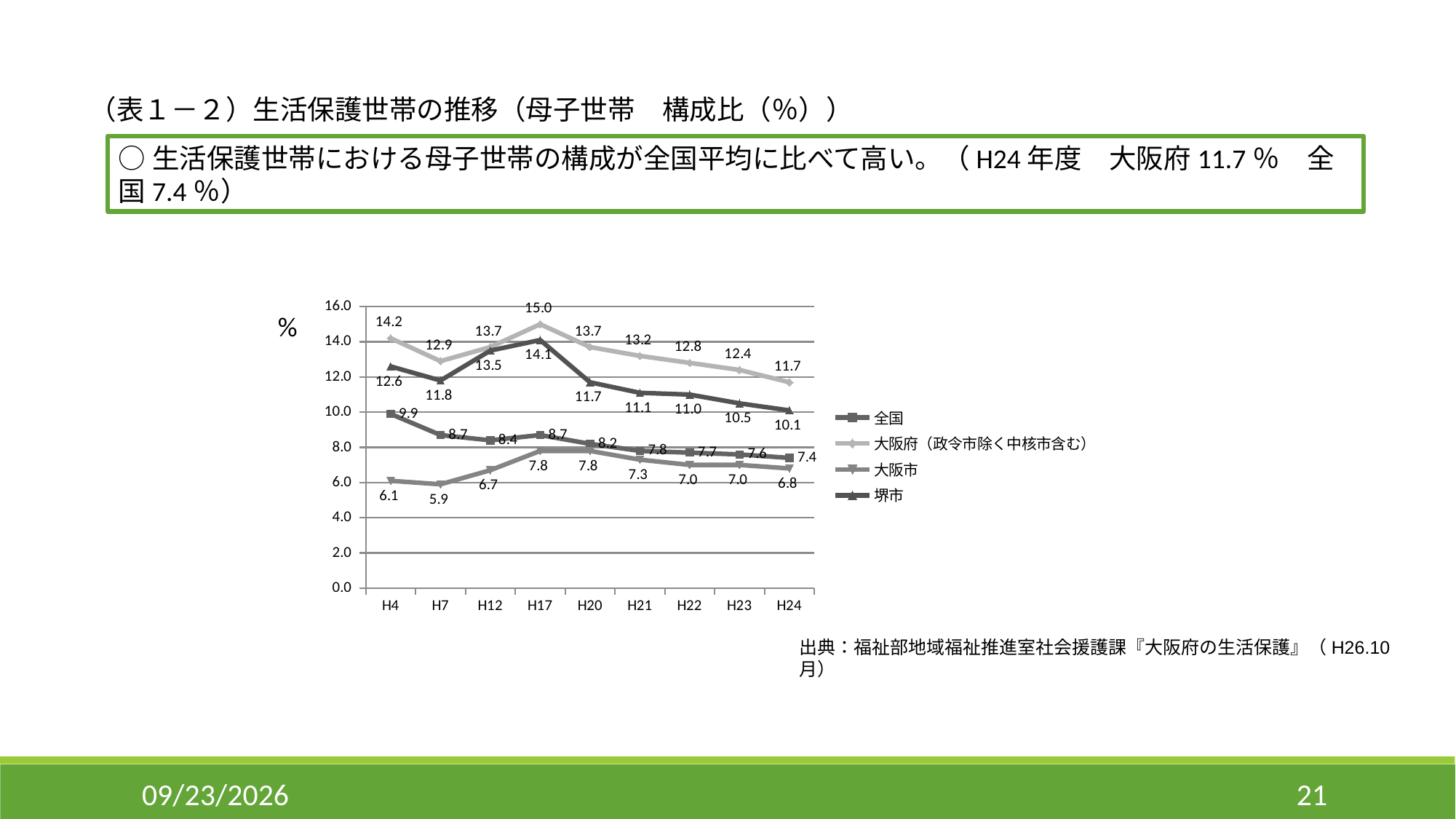
What is the value for 大阪府（政令市除く中核市含む） at H24? 11.7 What is the value for 大阪市 at H7? 5.9 Does the value for 全国 rise or fall from H4 to H24? fall What is the difference between 大阪府（政令市除く中核市含む） and 全国 at H24? 4.3 Which is larger at H20, the value for 堺市 or the value for 全国? 堺市 What is the value for 全国 at H4? 9.9 What is the value for 堺市 at H17? 14.1 How many series does the legend list? 4 What kind of chart is shown on the slide? line chart At which x-axis point does 大阪府（政令市除く中核市含む） reach its highest value? H17 How many points are on the x axis of the chart? 9 At which x-axis point is the value for 大阪市 lowest? H7